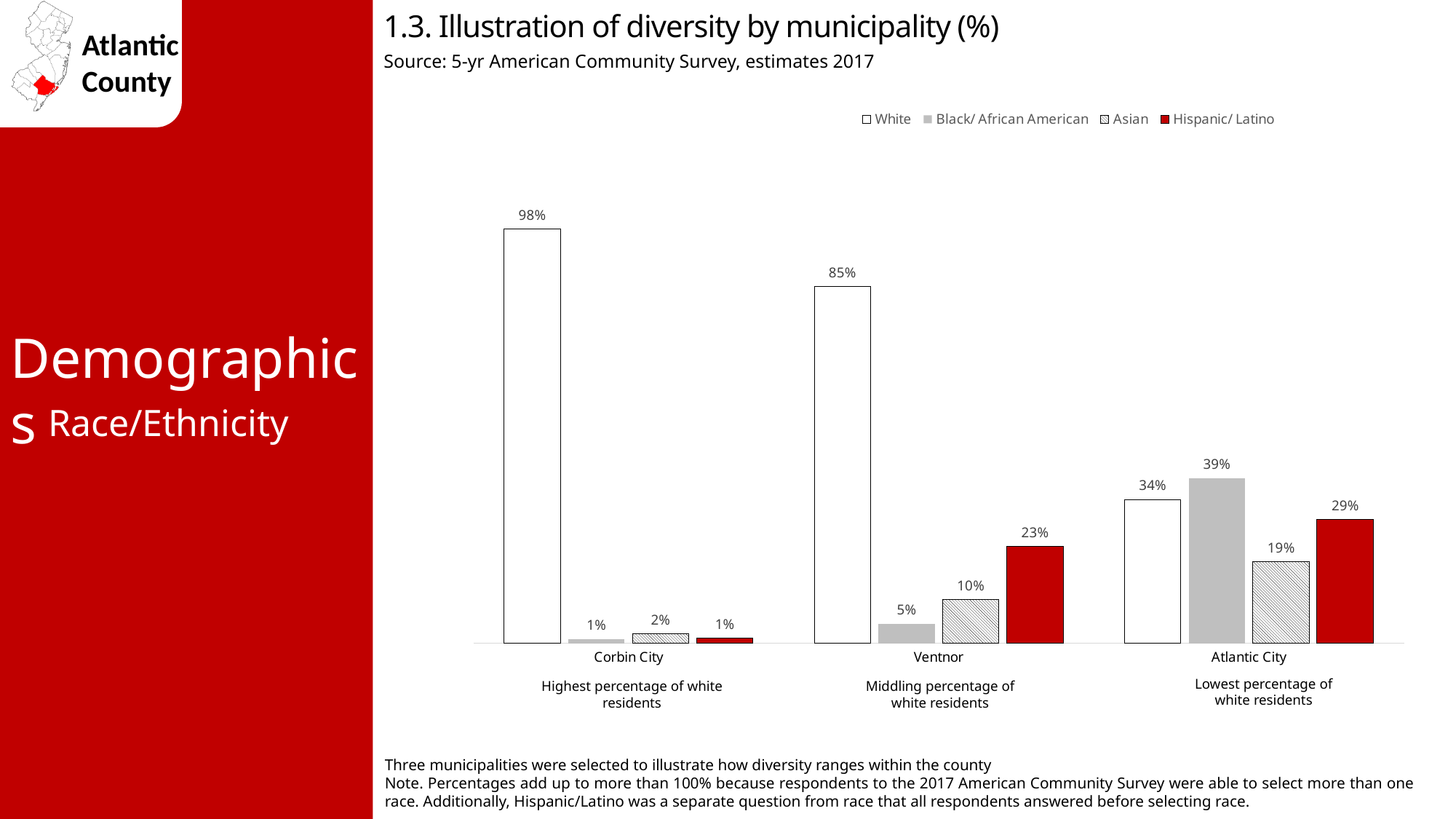
What is the difference between the White percentage in Corbin City and in Ventnor? 13% What is the Asian percentage for Ventnor? 10% What is the White percentage for Corbin City? 98% What kind of chart is shown on the slide? Bar chart Which municipality has the lowest Hispanic/ Latino percentage? Corbin City Which series is shown in red on the chart? Hispanic/ Latino How many municipalities are shown on the chart? 3 How many series does the legend list? 4 What is the Hispanic/ Latino percentage for Ventnor? 23% In Atlantic City, which is larger: the White percentage or the Black/ African American percentage? Black/ African American What is the Black/ African American percentage for Atlantic City? 39% Which municipality has the highest White percentage? Corbin City